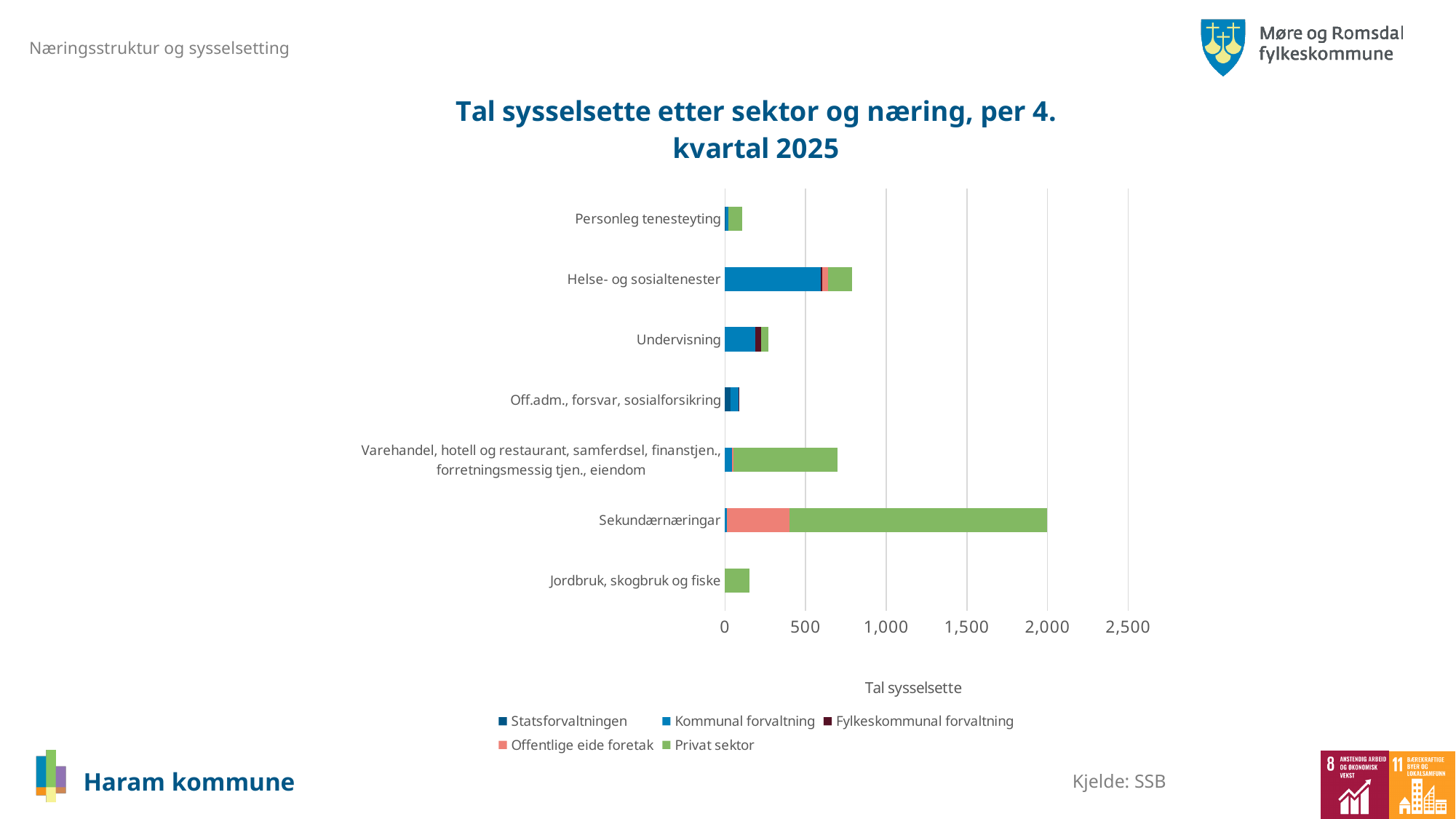
How many series does the legend list? 5 How many categories (næringar) are shown on the y axis of the chart? 7 Which category has the longest total bar? Sekundærnæringar Is the total value for Helse- og sosialtenester greater or less than 500? greater What is the title of the chart? Tal sysselsette etter sektor og næring, per 4. kvartal 2025 Is the total value for Jordbruk, skogbruk og fiske greater or less than 500? less What kind of chart is shown on the slide? bar chart Is the total value for Undervisning greater or less than 500? less Which has the larger total bar, Undervisning or Jordbruk, skogbruk og fiske? Undervisning Which legend entry is shown in green? Privat sektor Which has the larger total bar, Sekundærnæringar or Helse- og sosialtenester? Sekundærnæringar